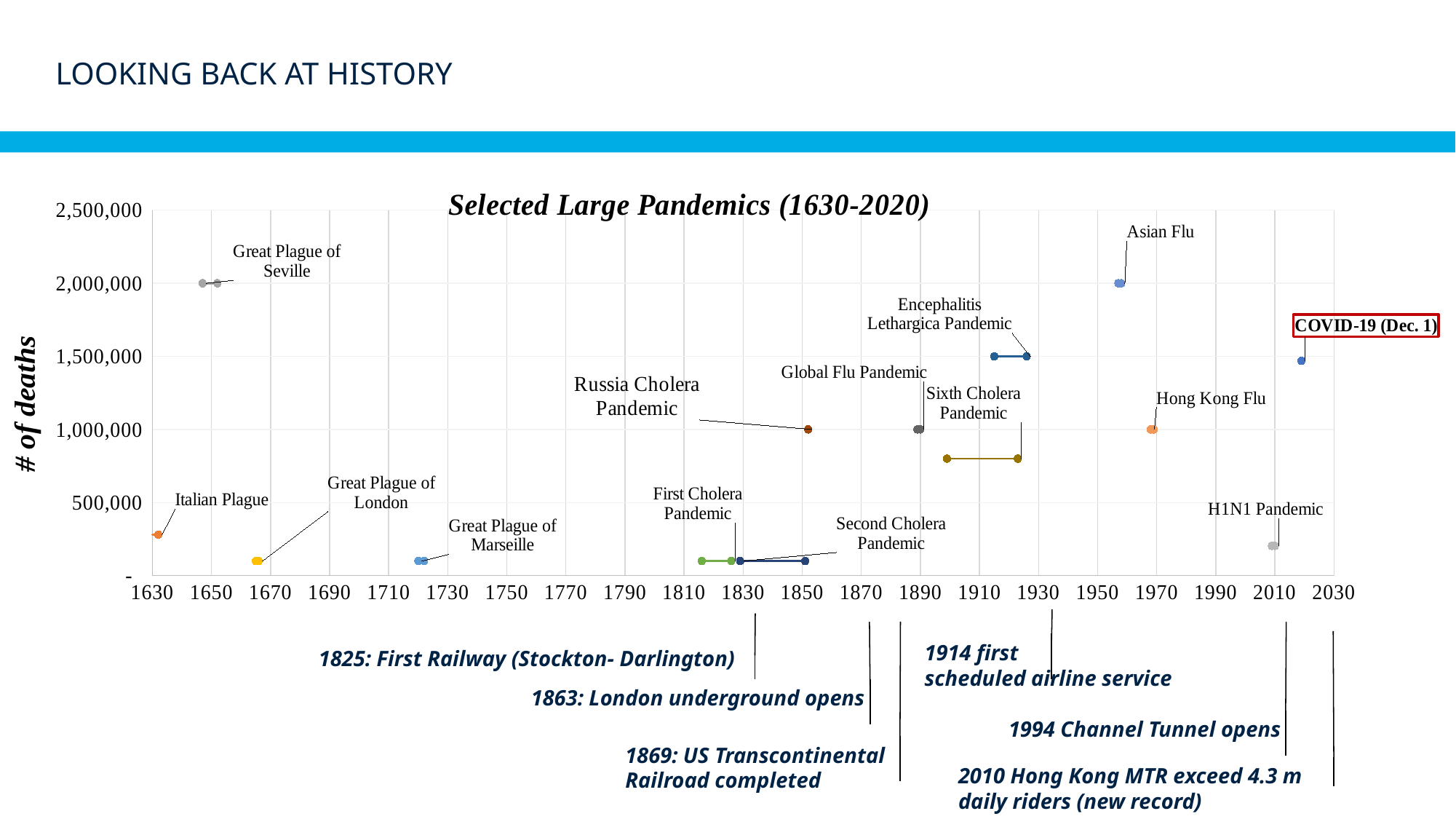
What is the label on the vertical axis of the chart? # of deaths Is the number of deaths for the Sixth Cholera Pandemic greater or less than 1,000,000? less Is the number of deaths for COVID-19 (Dec. 1) greater or less than 1,000,000? greater How many deaths are plotted for the Asian Flu? 2,000,000 How many pandemics are labelled on the chart? 14 How many deaths are plotted for the Hong Kong Flu? 1,000,000 Which had more deaths, the Hong Kong Flu or the H1N1 Pandemic? Hong Kong Flu How many deaths are plotted for the Great Plague of Seville? 2,000,000 Which had more deaths, the Asian Flu or the Hong Kong Flu? Asian Flu What is the title of the chart? Selected Large Pandemics (1630-2020) What kind of chart is shown on the slide? scatter chart What is the difference in deaths between the Asian Flu and the Hong Kong Flu? 1,000,000